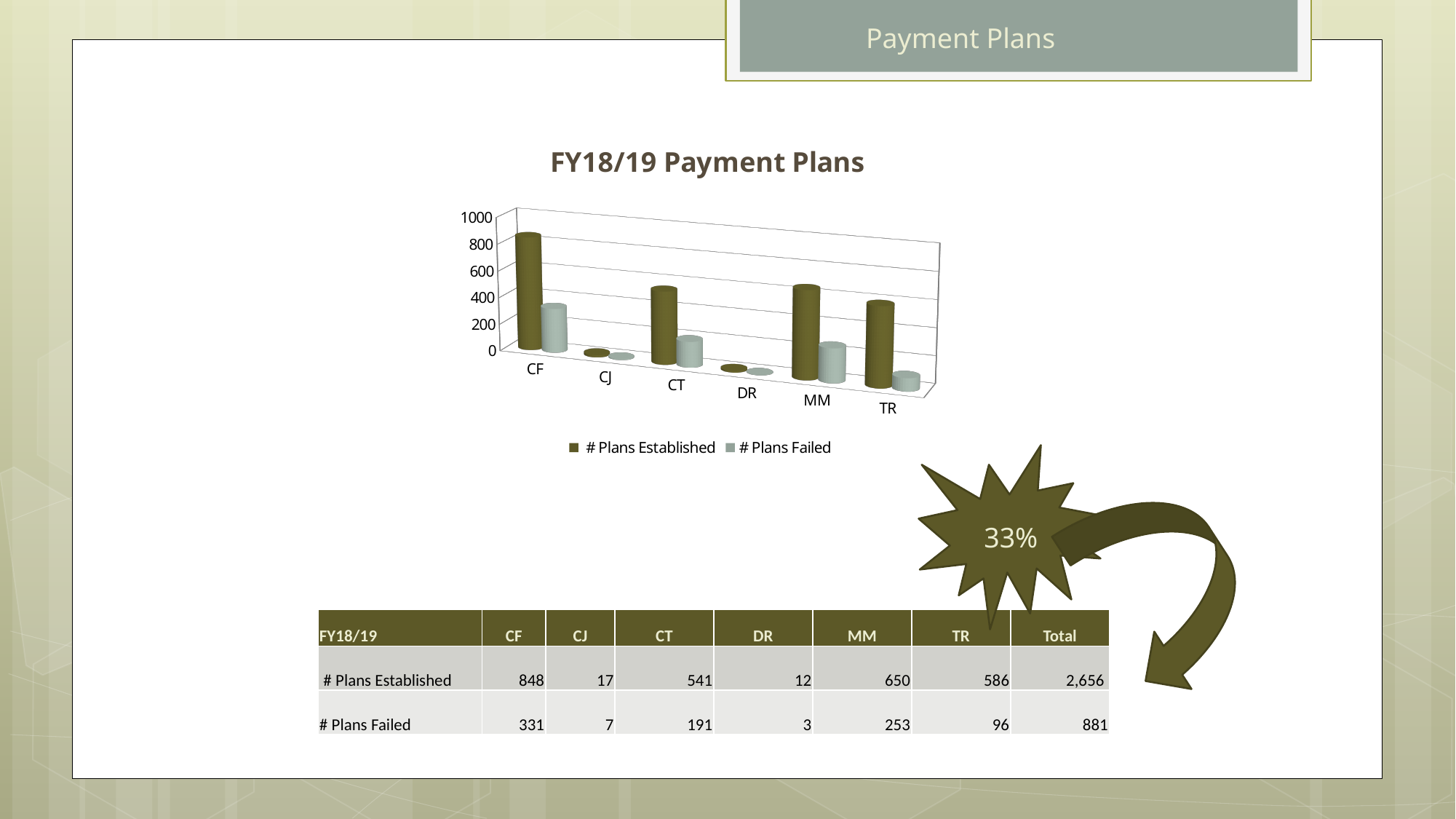
According to the table, how many plans failed for CT? 191 Which category has the highest number of plans established? CF Which category has the lowest number of plans failed? DR What kind of chart is shown on the slide? bar chart What is the title of the chart? FY18/19 Payment Plans According to the table, how many plans were established for MM? 650 Is the value for # Plans Established for CF greater or less than 800? greater How many series does the chart legend list? 2 Which is larger: # Plans Established for MM or # Plans Established for TR? MM Is the value for # Plans Failed for TR greater or less than 200? less What is the difference between # Plans Established and # Plans Failed for CF, using the table values? 517 How many categories are shown on the x axis of the chart? 6